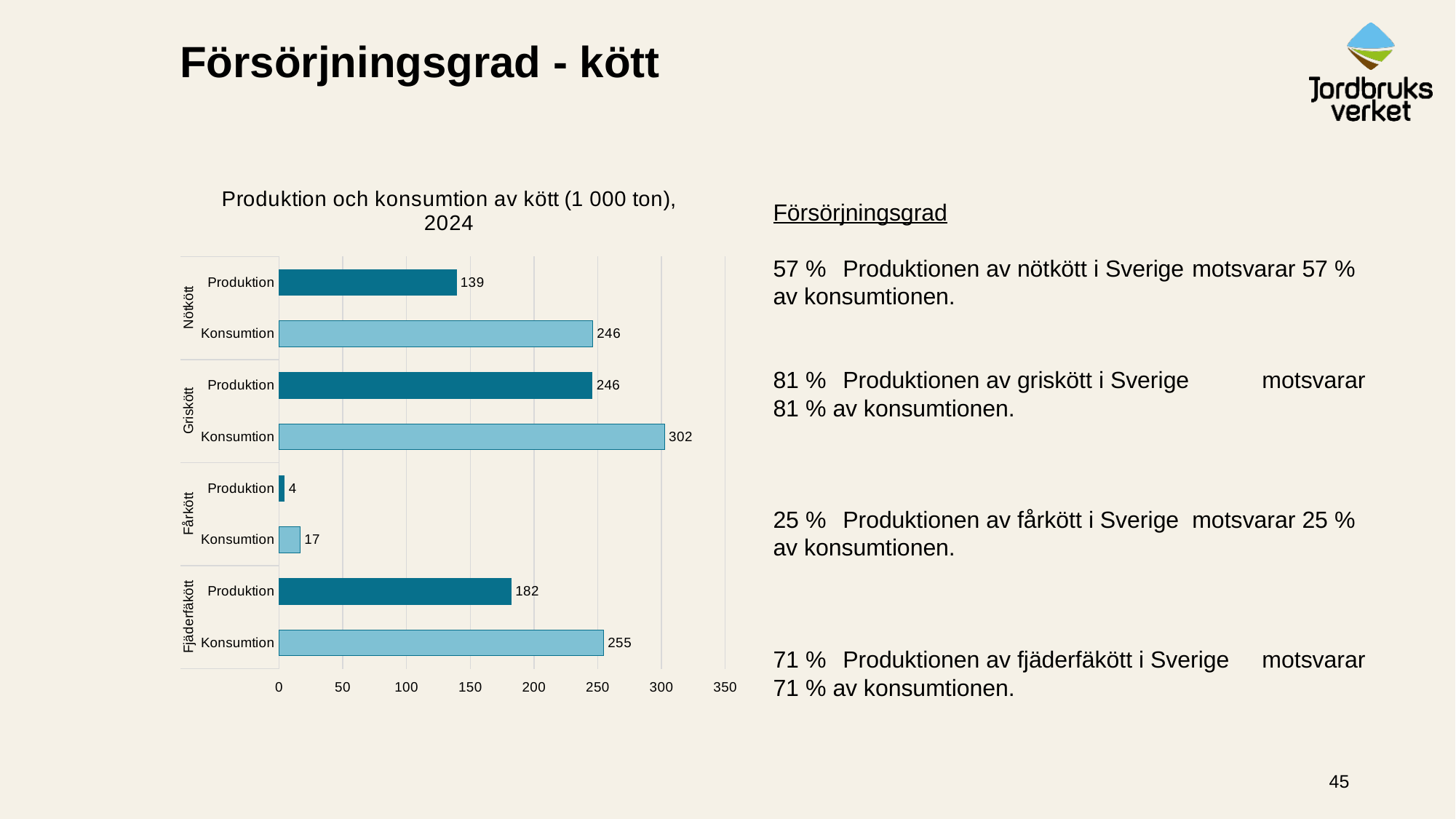
What is the Produktion value for Fårkött? 4 What is the difference between Konsumtion and Produktion for Nötkött? 107 Which is larger: Produktion for Griskött or Konsumtion for Nötkött? They are equal (246) How many meat types are shown in the chart? 4 What kind of chart is shown on the slide? Bar chart Is the Produktion value for Fjäderfäkött greater or less than 200? less What is the Konsumtion value for Fjäderfäkött? 255 What is the Produktion value for Nötkött? 139 Which meat type has the lowest Produktion value? Fårkött What is the Konsumtion value for Griskött? 302 What is the difference between Konsumtion and Produktion for Fjäderfäkött? 73 Which meat type has the highest Konsumtion value? Griskött